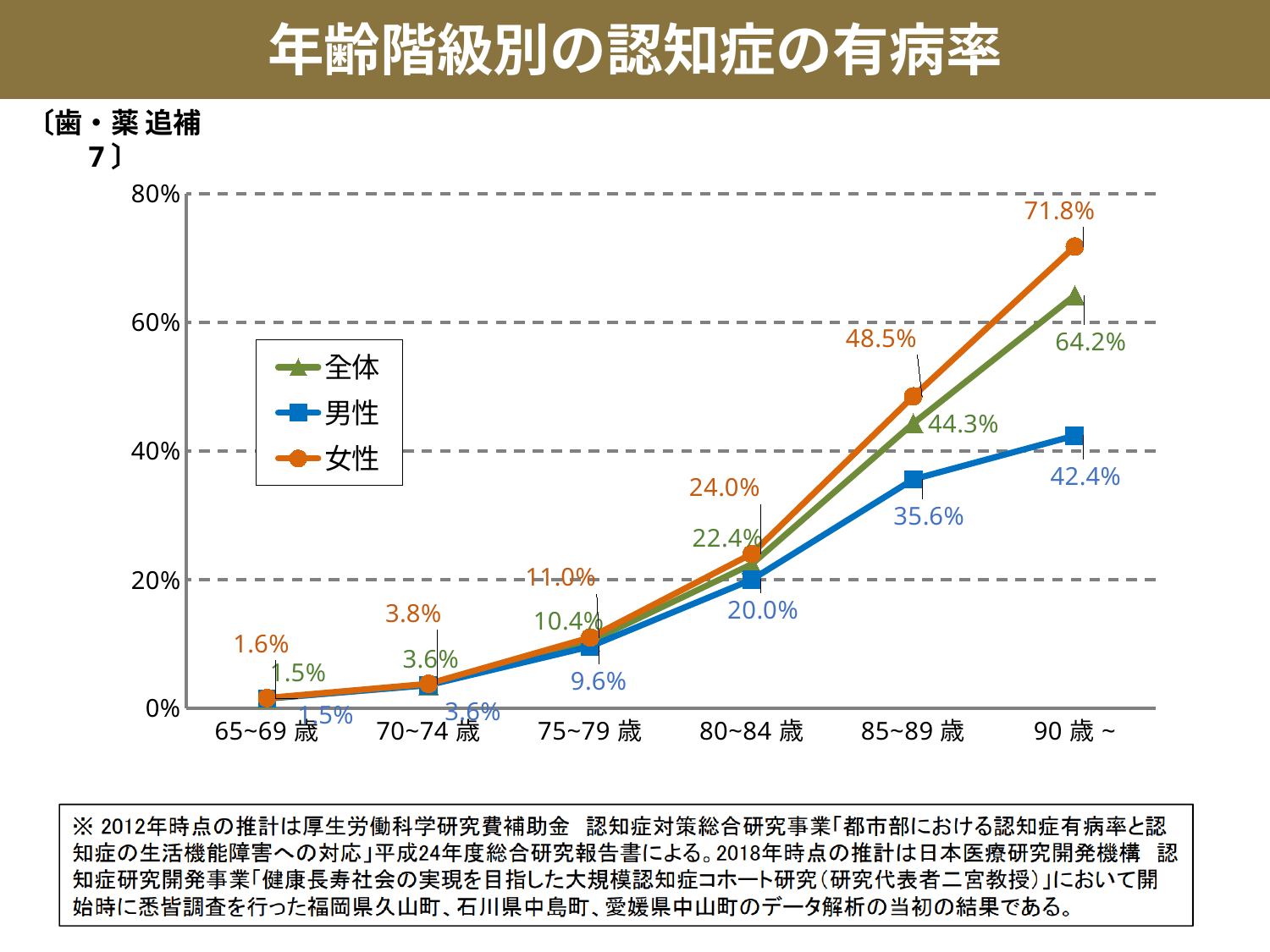
What kind of chart is shown on the slide? Line chart Which age group has the highest value for 女性? 90 歳～ Do the values for 男性 rise or fall as the age groups increase along the x axis? Rise Which age group has the lowest value for 全体? 65~69 歳 What is the value for 女性 in the 90 歳～ age group? 71.8% What is the value for 男性 in the 75~79 歳 age group? 9.6% How many age groups are shown on the x axis? 6 In the 85~89 歳 age group, which is larger, the value for 女性 or the value for 男性? 女性 How many series does the legend list? 3 What is the value for 全体 in the 80~84 歳 age group? 22.4% What is the value for 男性 in the 85~89 歳 age group? 35.6% What is the difference between the 女性 and 男性 values in the 90 歳～ age group? 29.4%